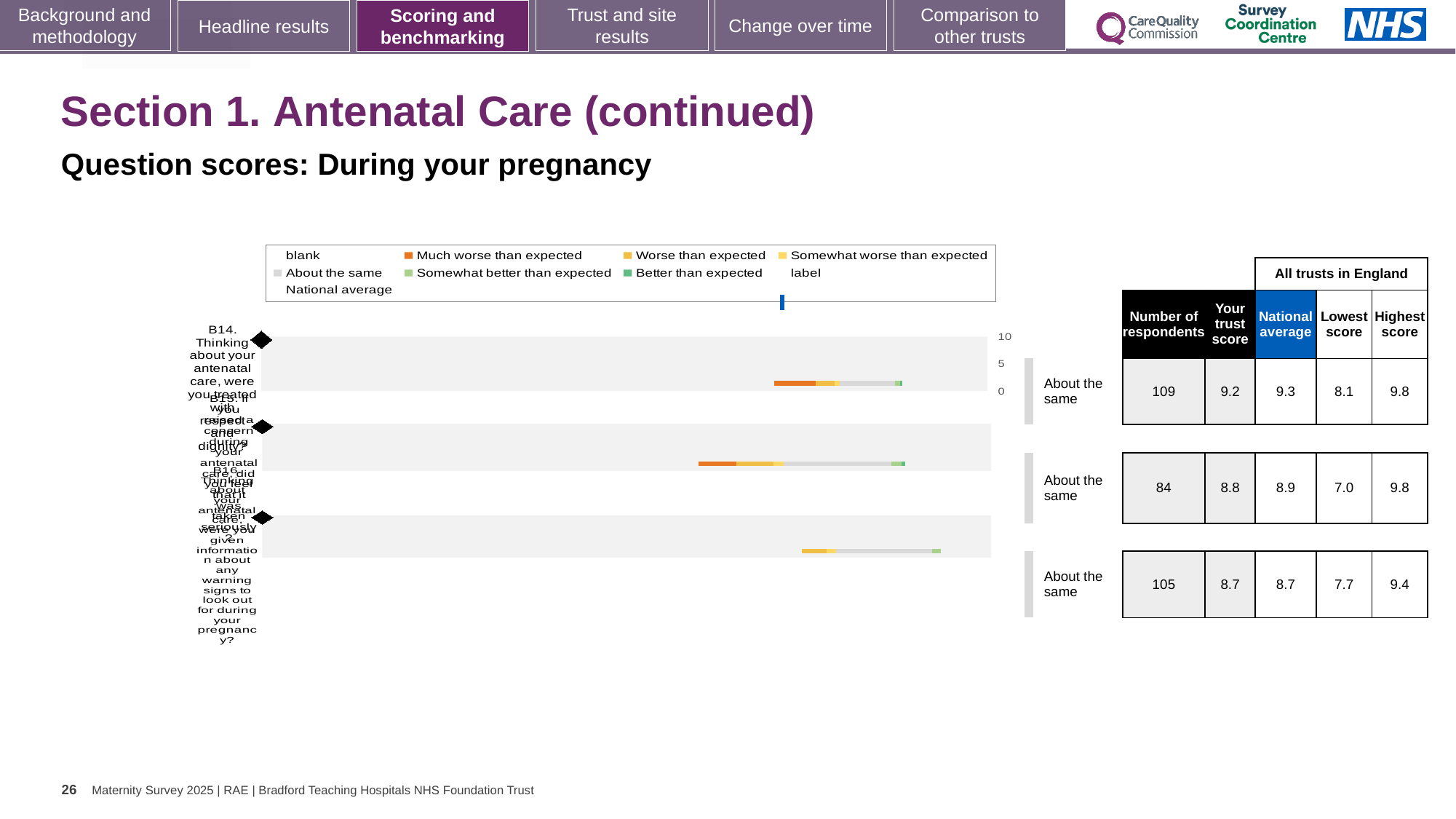
By how much does the national average exceed the trust score for the first (top) question, B14? 0.1 What is the lowest score for the second (middle) question in the table? 7.0 What is the 'Your trust score' for the first (top) question, B14? 9.2 What is the highest score for the third (bottom) question in the table? 9.4 What kind of chart is shown on the slide? bar chart Which question row has the highest number of respondents? the first (top) row, B14 Which has the larger 'Your trust score': the first (top) question or the second (middle) question? the first (top) question What is the national average for the first (top) question, B14? 9.3 How many question bars are plotted in the chart? 3 In the table next to the chart, what is the number of respondents for the first (top) question, B14? 109 Which question row has the lowest 'Your trust score'? the third (bottom) row What benchmark category is shown beside each of the three bars? About the same